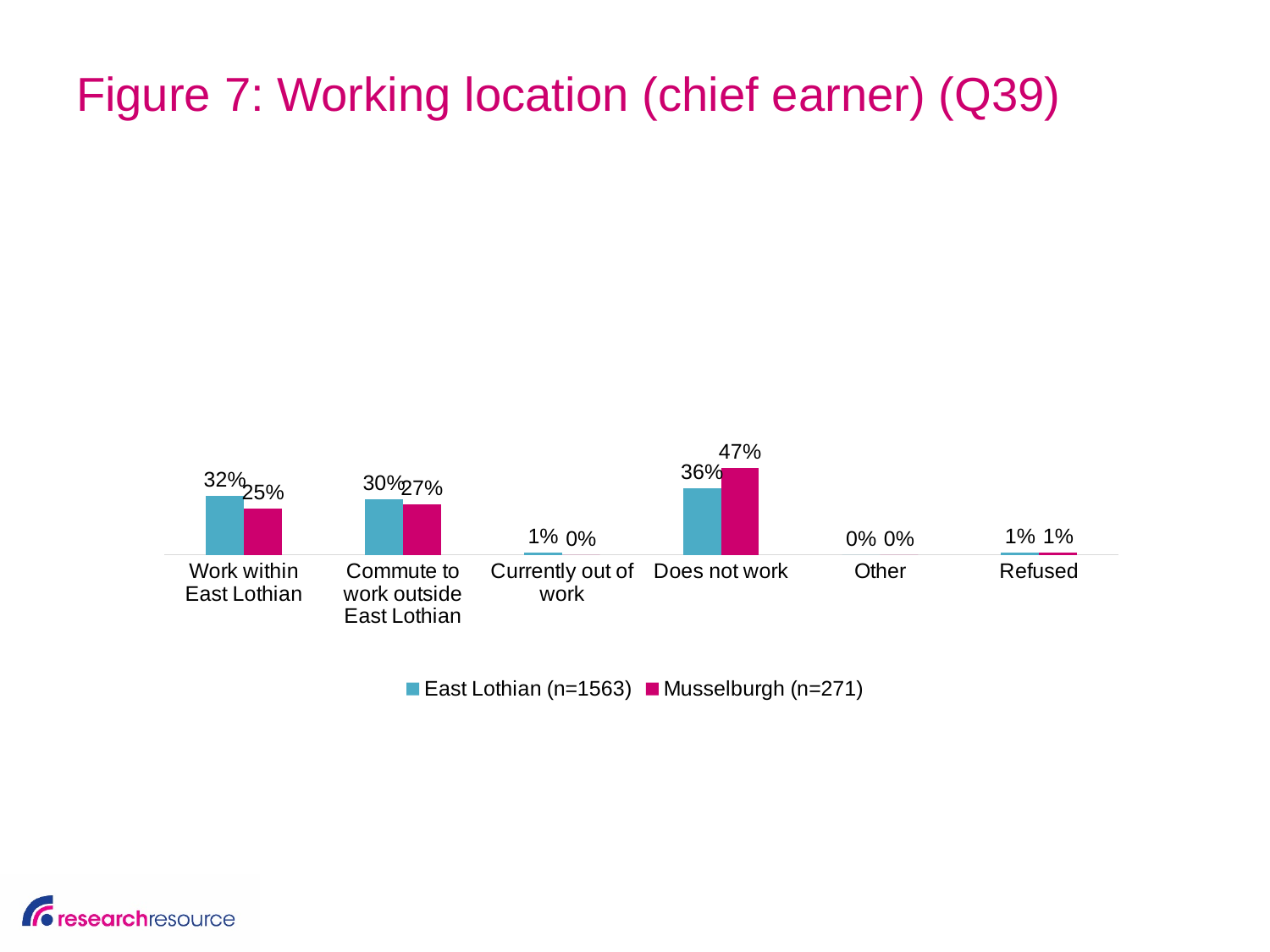
What is the Musselburgh value for 'Does not work'? 47% How many series does the legend list? 2 What is the difference between the East Lothian and Musselburgh values for 'Work within East Lothian'? 7 percentage points What is the difference between the Musselburgh and East Lothian values for 'Does not work'? 11 percentage points What percentage of East Lothian chief earners work within East Lothian? 32% What kind of chart is shown on the slide? Bar chart For 'Commute to work outside East Lothian', which series has the larger value, East Lothian or Musselburgh? East Lothian How many categories are shown on the x axis? 6 What is the Musselburgh value for 'Commute to work outside East Lothian'? 27% What is the sample size for Musselburgh shown in the legend? n=271 Which category has the highest value for East Lothian? Does not work Which category has the highest value for Musselburgh? Does not work